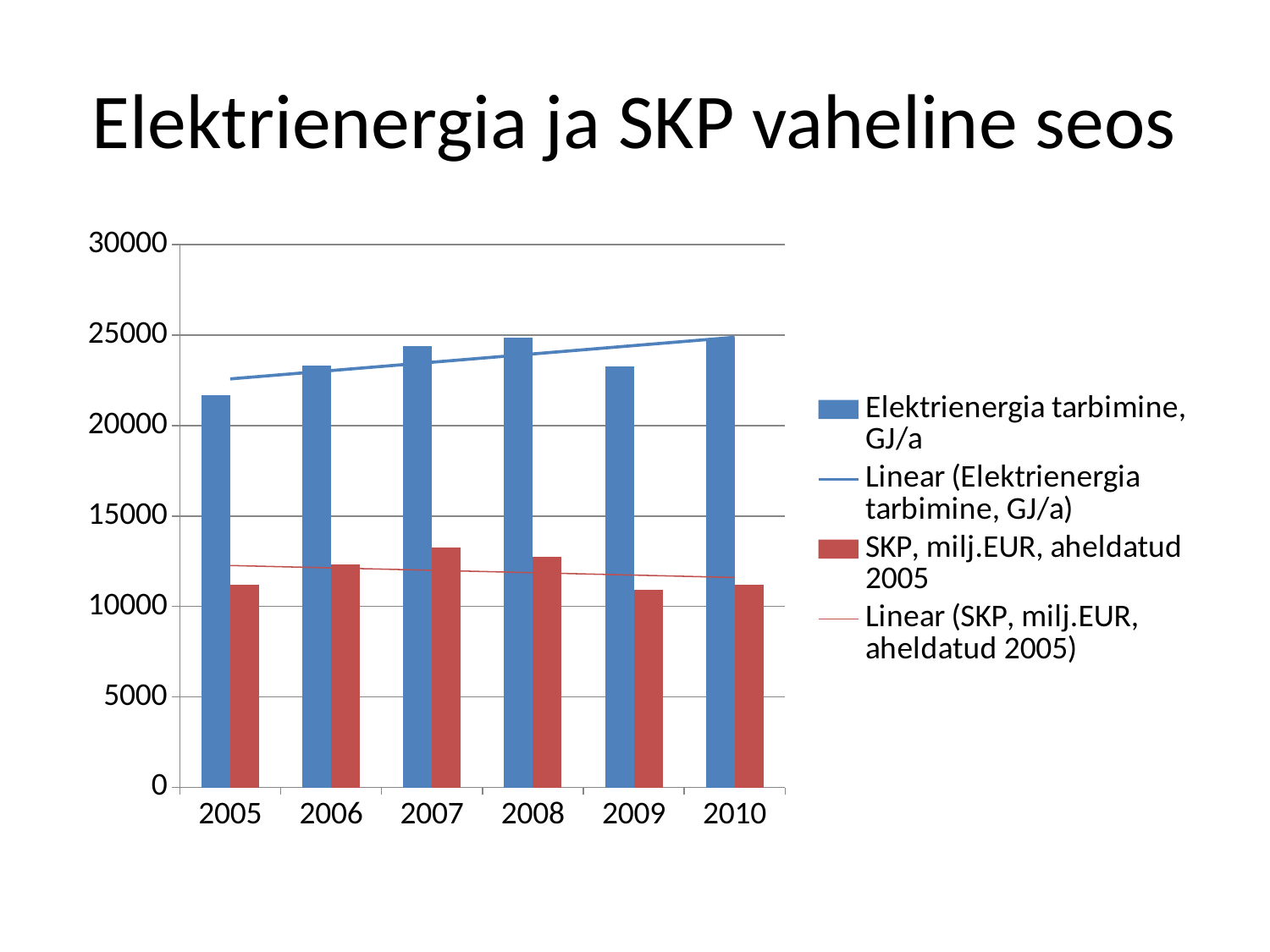
Does the linear trendline for 'Elektrienergia tarbimine, GJ/a' rise or fall from 2005 to 2010? rise Which is larger: 'Elektrienergia tarbimine, GJ/a' in 2007 or in 2005? 2007 Is the value for 'SKP, milj.EUR, aheldatud 2005' in 2007 greater or less than 15000? less Which colour represents the series 'SKP, milj.EUR, aheldatud 2005'? red Is the value for 'Elektrienergia tarbimine, GJ/a' in 2005 greater or less than 20000? greater What is the title of the slide containing the chart? Elektrienergia ja SKP vaheline seos In which year is the 'Elektrienergia tarbimine, GJ/a' bar the lowest? 2005 What kind of chart is shown on the slide? bar chart How many entries does the chart's legend list? 4 How many years are shown on the x axis of the chart? 6 In which year is the 'SKP, milj.EUR, aheldatud 2005' bar the highest? 2007 Is the value for 'SKP, milj.EUR, aheldatud 2005' in 2009 greater or less than 10000? greater